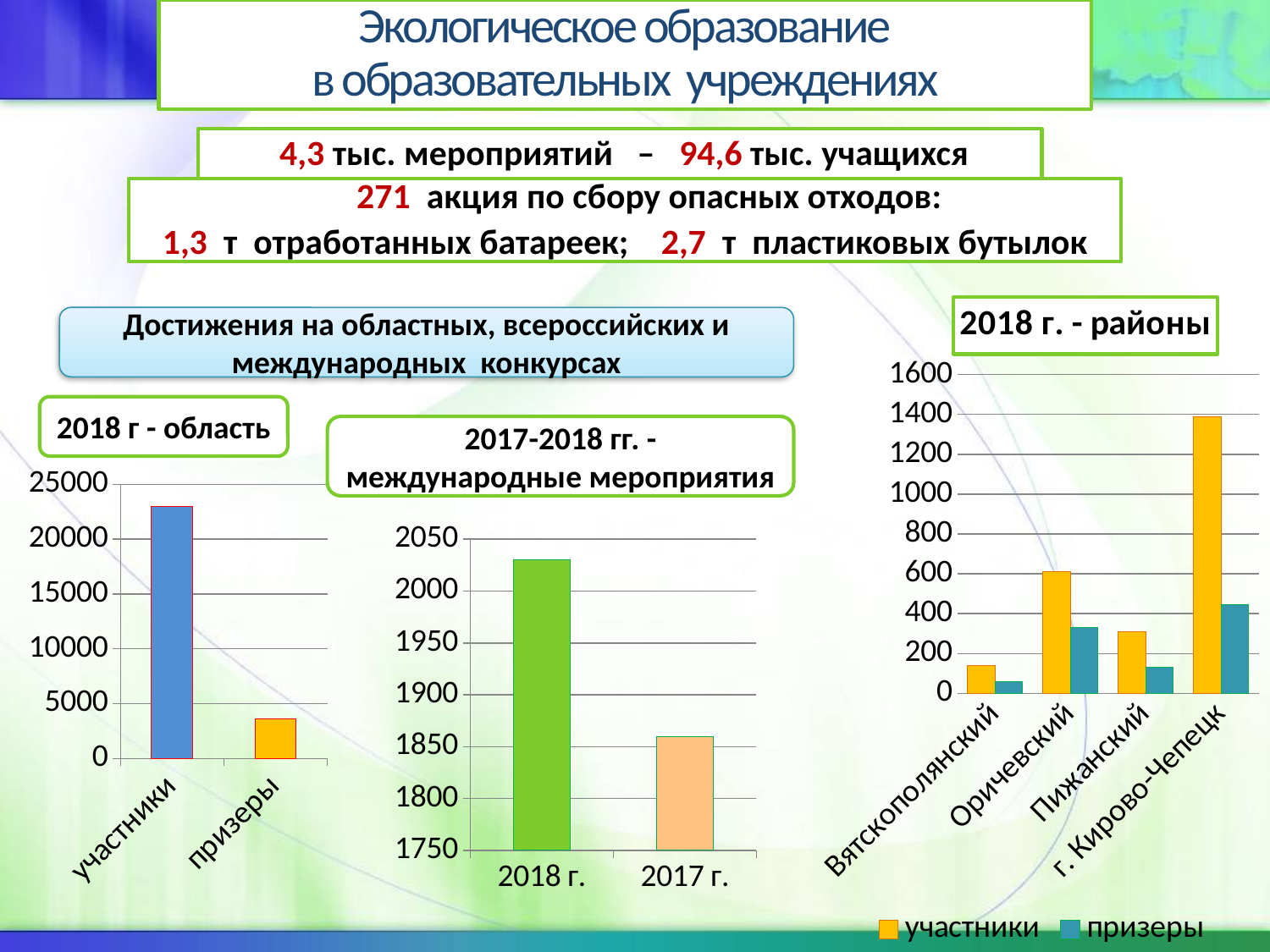
In the chart titled "2018 г. - районы", is the value for участники in г. Кирово-Чепецк greater or less than 1200? greater How many series does the legend of the chart titled "2018 г. - районы" list? 2 What kind of chart is the chart titled "2018 г. - районы"? bar chart In the chart titled "2017-2018 гг. - международные мероприятия", is the value for 2017 г. greater or less than 1900? less In the chart titled "2018 г - область", which category has the higher value, участники or призеры? участники In the chart titled "2018 г - область", is the value for участники greater or less than 20000? greater In the chart titled "2018 г. - районы", which district has the lowest value for призеры? Вятскополянский In the chart titled "2018 г. - районы", which district has the highest value for участники? г. Кирово-Чепецк In the chart titled "2017-2018 гг. - международные мероприятия", which year has the higher value? 2018 г. How many categories are shown in the chart titled "2018 г - область"? 2